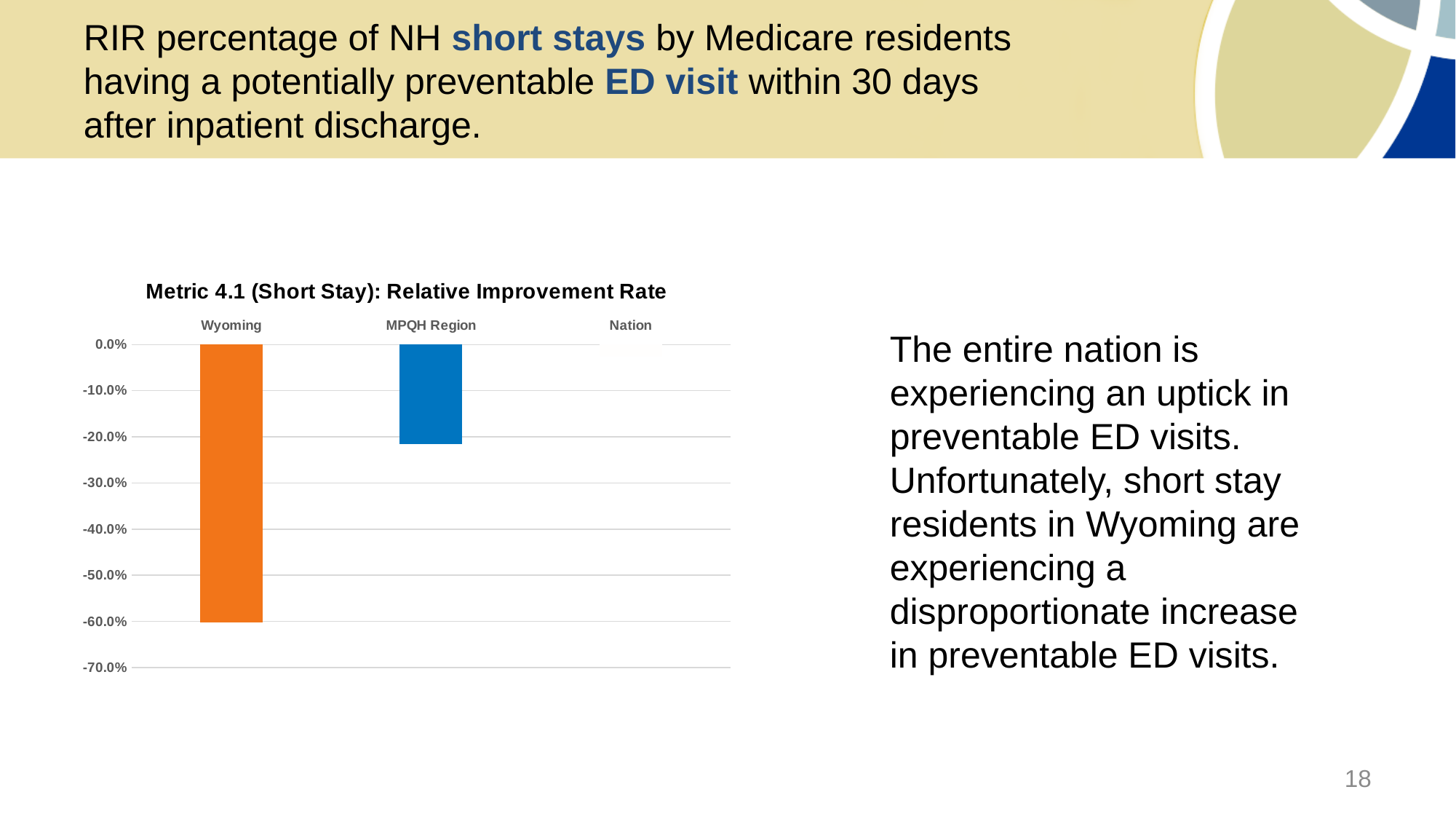
Which has the larger relative improvement rate, Wyoming or MPQH Region? MPQH Region What is the lowest value shown on the chart's y axis? -70.0% What kind of chart is shown on the slide? bar chart What colour is the bar for Wyoming? orange Is the value for MPQH Region greater or less than -10.0%? less Is the value for Wyoming greater or less than -70.0%? greater Is the value for Wyoming greater or less than -50.0%? less Which category has the lowest (most negative) relative improvement rate? Wyoming Which category has the highest relative improvement rate? Nation How many categories are shown on the chart's x axis? 3 What is the title of the chart? Metric 4.1 (Short Stay): Relative Improvement Rate